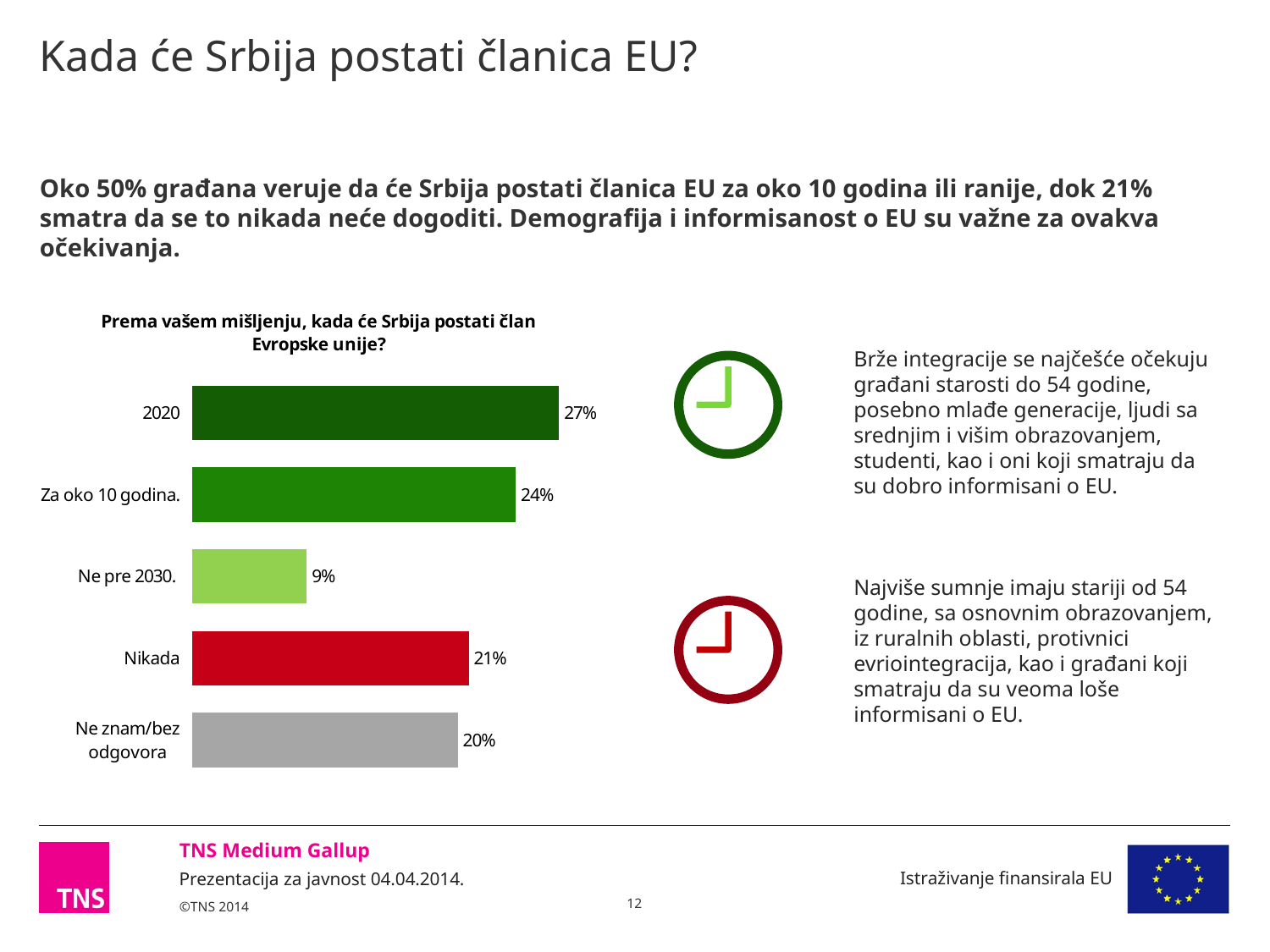
What percentage of respondents answered "2020"? 27% What is the value for "Ne znam/bez odgovora"? 20% What is the difference between the values for "2020" and "Nikada"? 6% What is the value for "Za oko 10 godina."? 24% What kind of chart is shown on the slide? Bar chart Which category has the lowest value? Ne pre 2030. What percentage of respondents answered "Nikada"? 21% What is the title of the chart? Prema vašem mišljenju, kada će Srbija postati član Evropske unije? What is the value for "Ne pre 2030."? 9% Which is larger, the value for "Za oko 10 godina." or the value for "Ne pre 2030."? Za oko 10 godina. How many categories are shown in the chart? 5 Which category has the highest value? 2020